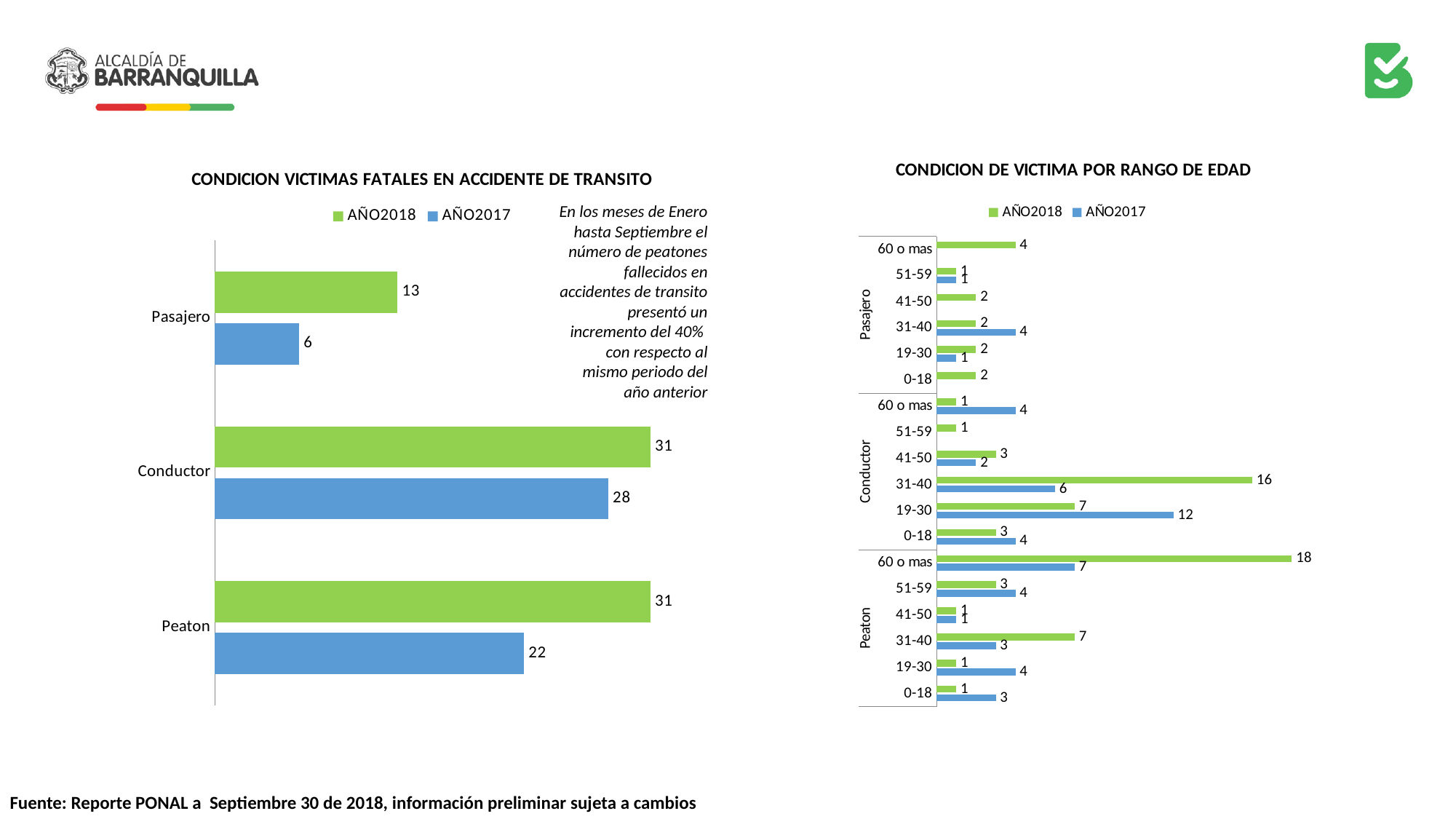
What kind of chart is 'CONDICION DE VICTIMA POR RANGO DE EDAD'? Bar chart In the chart 'CONDICION VICTIMAS FATALES EN ACCIDENTE DE TRANSITO', which is larger for Conductor: AÑO2018 or AÑO2017? AÑO2018 In the chart 'CONDICION VICTIMAS FATALES EN ACCIDENTE DE TRANSITO', what is the value for Pasajero in AÑO2017? 6 In the chart 'CONDICION VICTIMAS FATALES EN ACCIDENTE DE TRANSITO', how many series does the legend list? 2 In the chart 'CONDICION VICTIMAS FATALES EN ACCIDENTE DE TRANSITO', which category has the lowest AÑO2017 value? Pasajero In the chart 'CONDICION DE VICTIMA POR RANGO DE EDAD', which age range has the highest AÑO2018 value among Peaton? 60 o mas In the chart 'CONDICION VICTIMAS FATALES EN ACCIDENTE DE TRANSITO', what is the value for Peaton in AÑO2018? 31 In the chart 'CONDICION VICTIMAS FATALES EN ACCIDENTE DE TRANSITO', how many categories are shown? 3 In the chart 'CONDICION DE VICTIMA POR RANGO DE EDAD', what is the difference between the AÑO2018 and AÑO2017 values for Peaton aged 60 o mas? 11 In the chart 'CONDICION VICTIMAS FATALES EN ACCIDENTE DE TRANSITO', what is the difference between the AÑO2018 and AÑO2017 values for Peaton? 9 In the chart 'CONDICION DE VICTIMA POR RANGO DE EDAD', what is the AÑO2018 value for Conductor aged 31-40? 16 In the chart 'CONDICION DE VICTIMA POR RANGO DE EDAD', what is the AÑO2017 value for Conductor aged 19-30? 12